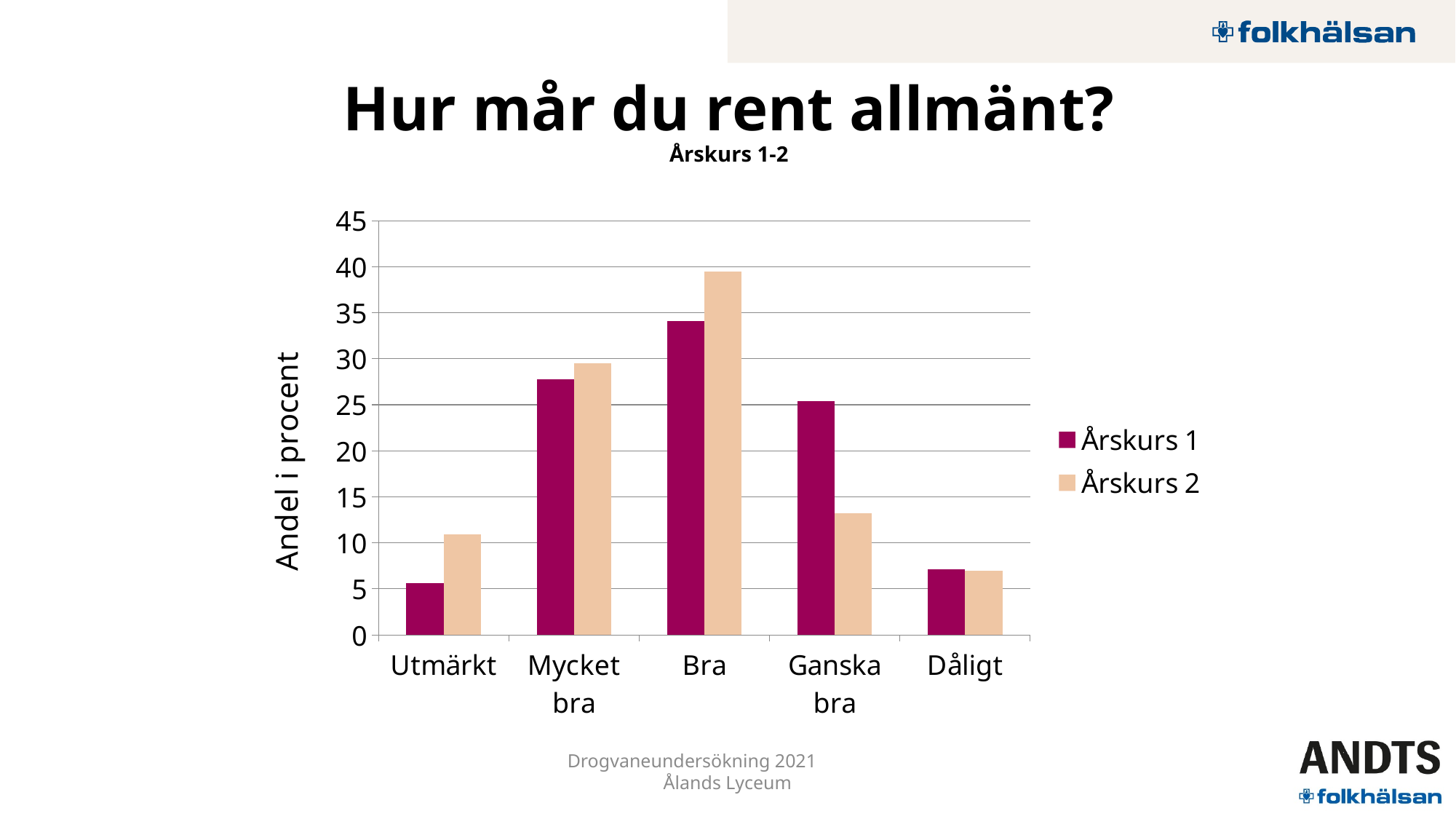
Which category has the lowest value for Årskurs 2? Dåligt How many categories are shown on the x axis of the chart? 5 Which category has the lowest value for Årskurs 1? Utmärkt For the category Ganska bra, which series has the larger value, Årskurs 1 or Årskurs 2? Årskurs 1 How many series does the legend list? 2 Is the value for Bra in the Årskurs 2 series greater or less than 35? greater Which category has the highest value for Årskurs 1? Bra What is the title of the vertical axis? Andel i procent Is the value for Ganska bra in the Årskurs 1 series greater or less than 20? greater What kind of chart is shown on the slide? bar chart Which category has the highest value for Årskurs 2? Bra For the category Utmärkt, which series has the larger value, Årskurs 1 or Årskurs 2? Årskurs 2